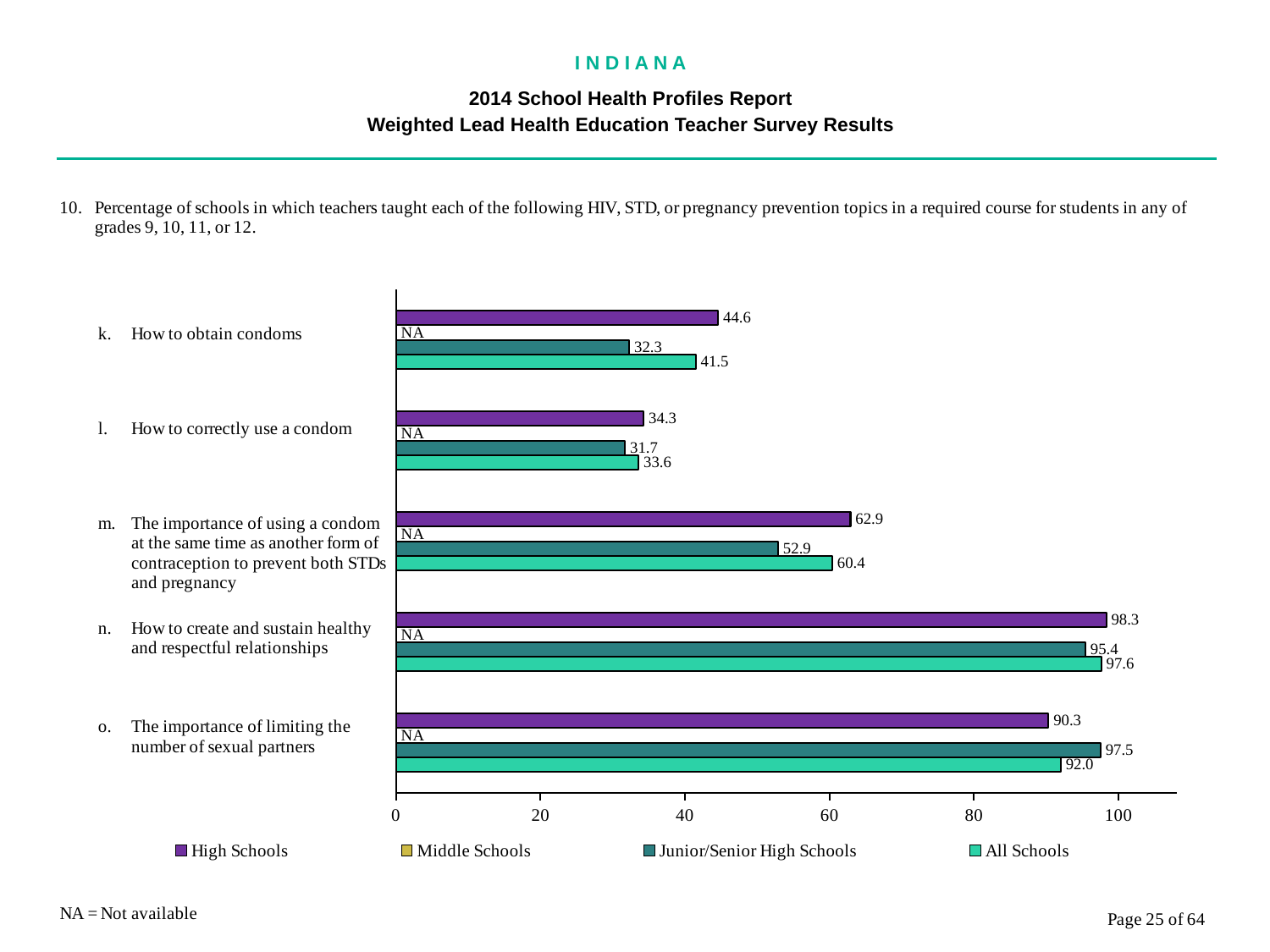
How many series does the legend list? 4 What is the Junior/Senior High Schools value for 'How to correctly use a condom'? 31.7 What value is shown for Middle Schools for every topic on the chart? NA Which topic has the highest High Schools value? How to create and sustain healthy and respectful relationships What is the High Schools value for 'How to obtain condoms'? 44.6 Is the All Schools value for 'How to obtain condoms' greater or less than 40? greater What is the difference between the High Schools and Junior/Senior High Schools values for 'The importance of using a condom at the same time as another form of contraception to prevent both STDs and pregnancy'? 10.0 What is the All Schools value for 'The importance of limiting the number of sexual partners'? 92.0 How many topics (categories) are shown on the chart? 5 What kind of chart is shown on the slide? Bar chart For 'The importance of limiting the number of sexual partners', which is larger: the High Schools value or the Junior/Senior High Schools value? Junior/Senior High Schools Which topic has the lowest All Schools value? How to correctly use a condom